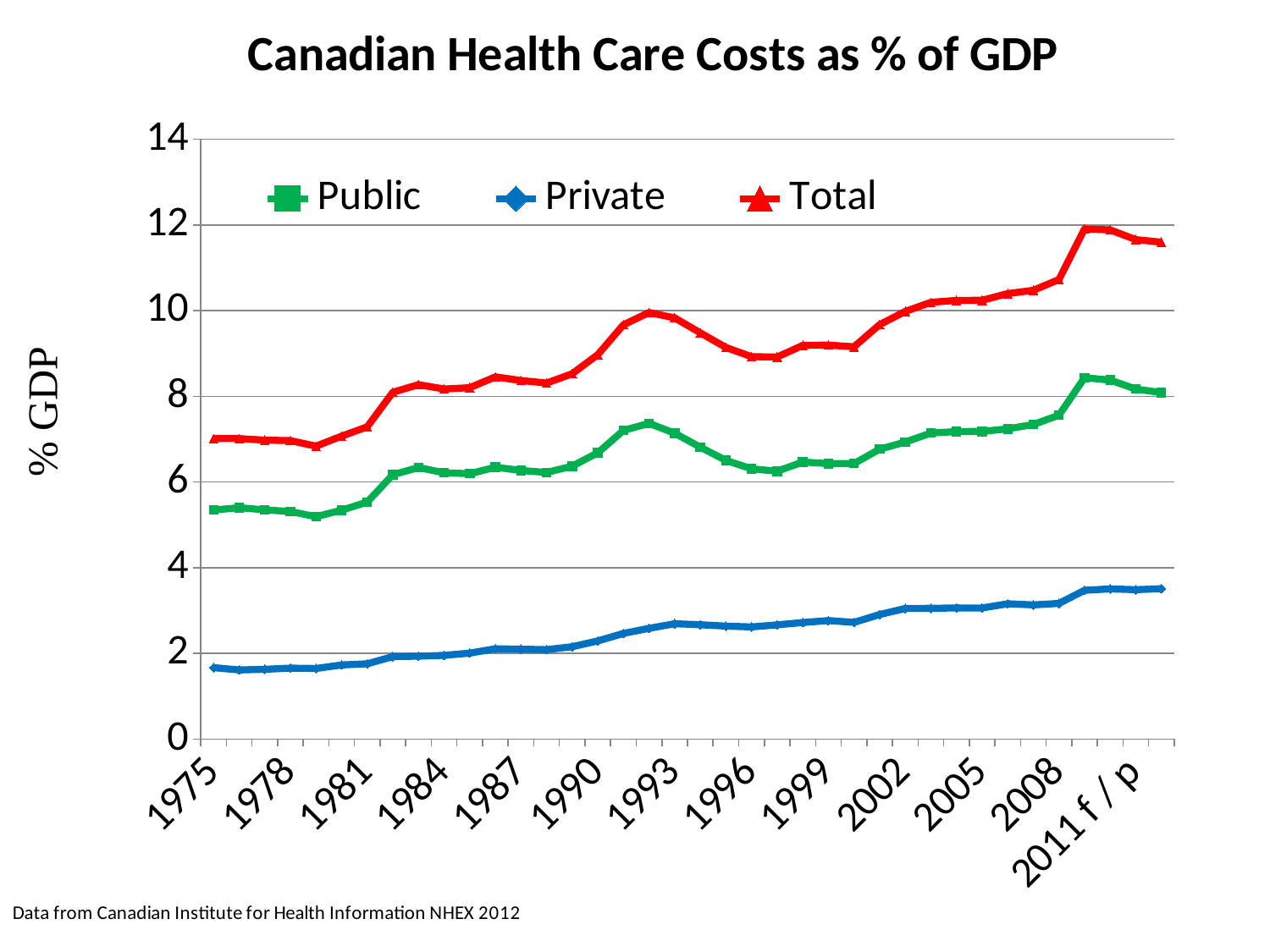
Which series has the lowest values throughout the chart? Private Is the value for Total in 2011 f / p greater or less than 10? greater Does the Private series generally rise or fall from 1975 to 2011 f / p? rise What is the title of the chart? Canadian Health Care Costs as % of GDP Which series has the highest values throughout the chart? Total What kind of chart is shown on the slide? line chart In 1975, which is larger, the Public value or the Private value? Public Is the value for Private in 1975 greater or less than 2? less Is the value for Private in 2011 f / p greater or less than 4? less What is the label on the vertical axis? % GDP How many series does the legend list? 3